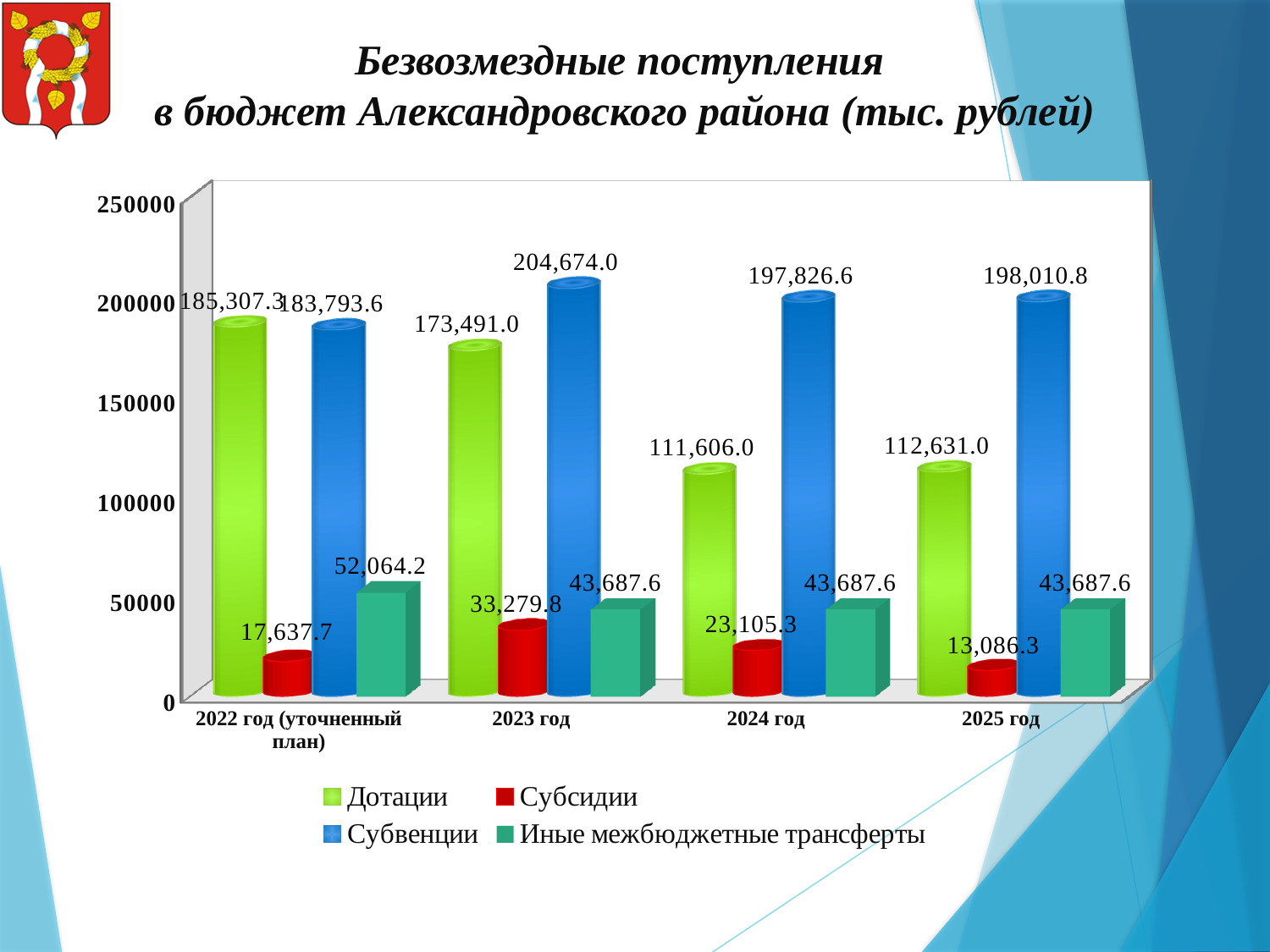
What is the value of Дотации for 2024 год? 111,606.0 What is the value of Субвенции for 2023 год? 204,674.0 In which year is the Дотации value lowest? 2024 год What kind of chart is shown on the slide? Bar chart What is the value of Иные межбюджетные трансферты for 2022 год (уточненный план)? 52,064.2 What is the difference between the Субсидии values for 2023 год and 2024 год? 10,174.5 How many series does the legend list? 4 What is the value of Субсидии for 2025 год? 13,086.3 How many year categories are shown on the x axis? 4 In which year is the Субсидии value highest? 2023 год Which series is shown in red in the legend? Субсидии Which is larger for 2022 год (уточненный план): Дотации or Субвенции? Дотации